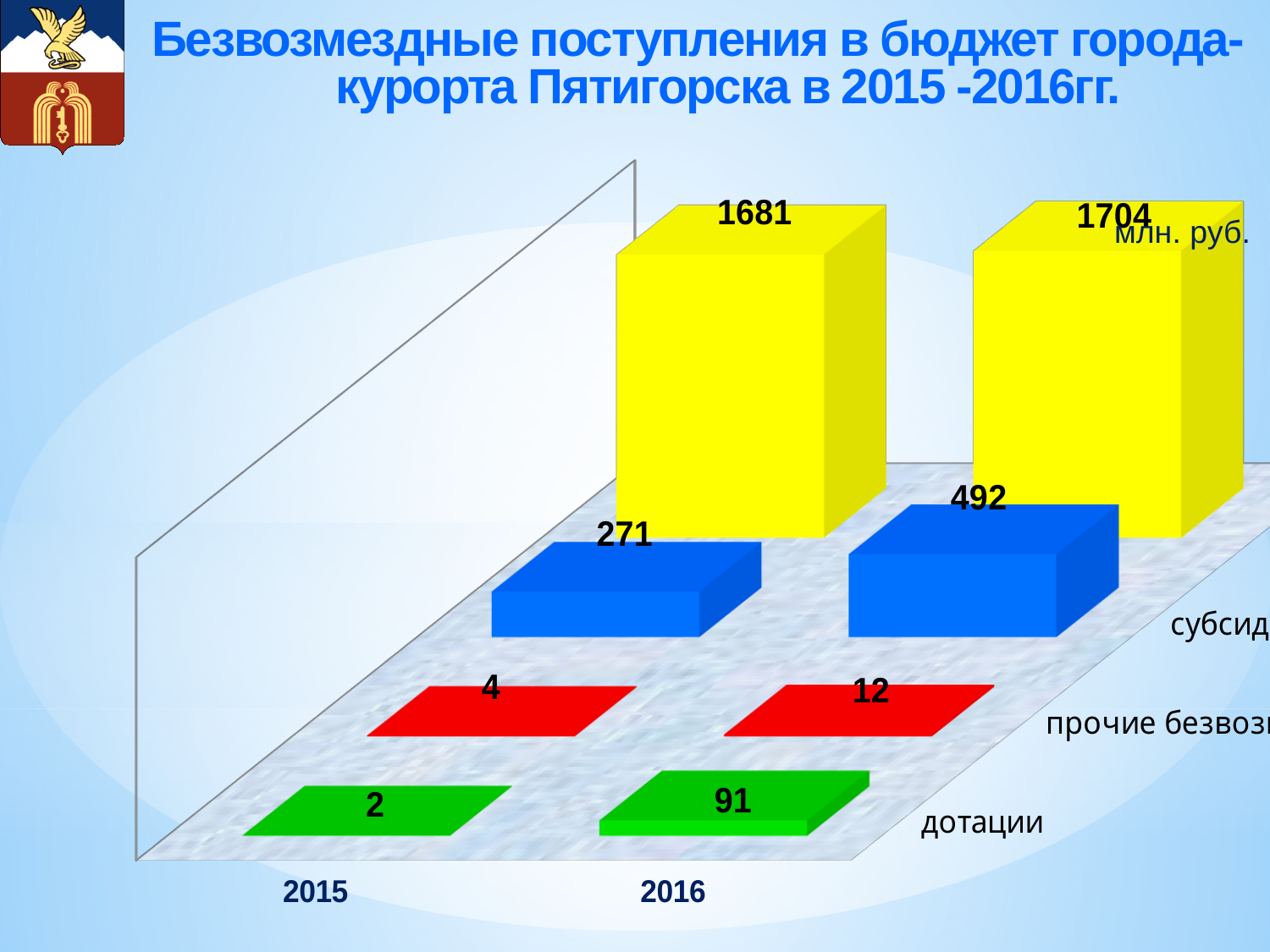
What is the value for дотации in 2015? 2 What is the value shown on the blue bar for 2015? 271 By how much did дотации increase from 2015 to 2016? 89 What is the difference between the blue bar values for 2016 and 2015? 221 Do the values for дотации rise or fall from 2015 to 2016? rise What unit of measurement is indicated on the chart? млн. руб. What is the value for дотации in 2016? 91 What is the value shown on the red bar for 2016? 12 What is the value shown on the yellow bar for 2016? 1704 What kind of chart is shown on the slide? bar chart Which year has the higher value for дотации, 2015 or 2016? 2016 How many years are shown on the x axis of the chart? 2